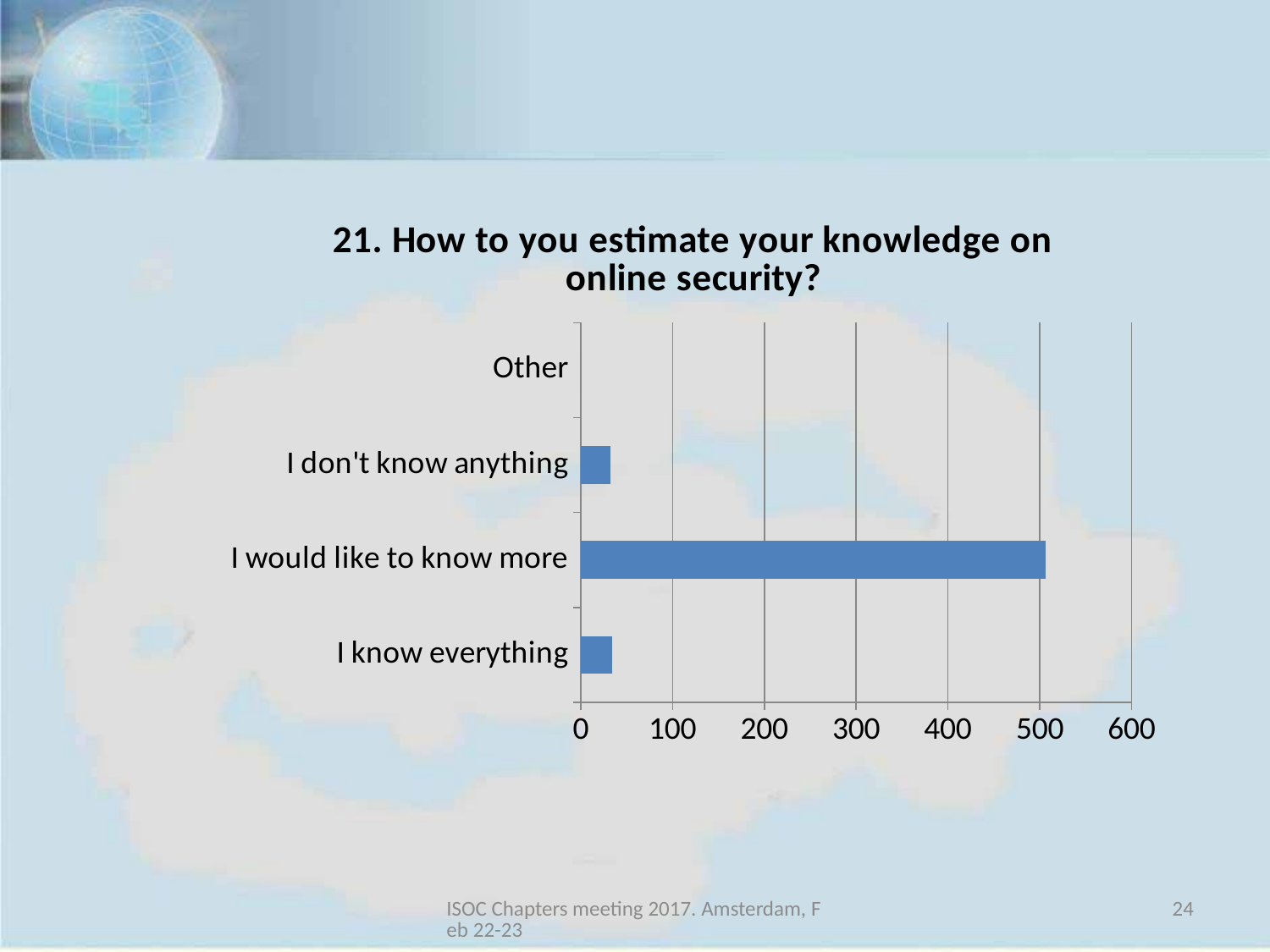
What kind of chart is shown on the slide? bar chart Which is larger, the value for "I don't know anything" or the value for "Other"? I don't know anything Which category has the highest value? I would like to know more How many categories are shown on the chart? 4 What is the highest value shown on the horizontal axis? 600 Which category has the lowest value? Other Is the value for "I would like to know more" greater or less than 400? greater Which is larger, the value for "I would like to know more" or the value for "I know everything"? I would like to know more Is the value for "I would like to know more" greater or less than 600? less Is the value for "I know everything" greater or less than 100? less What is the title of the chart? 21. How to you estimate your knowledge on online security?